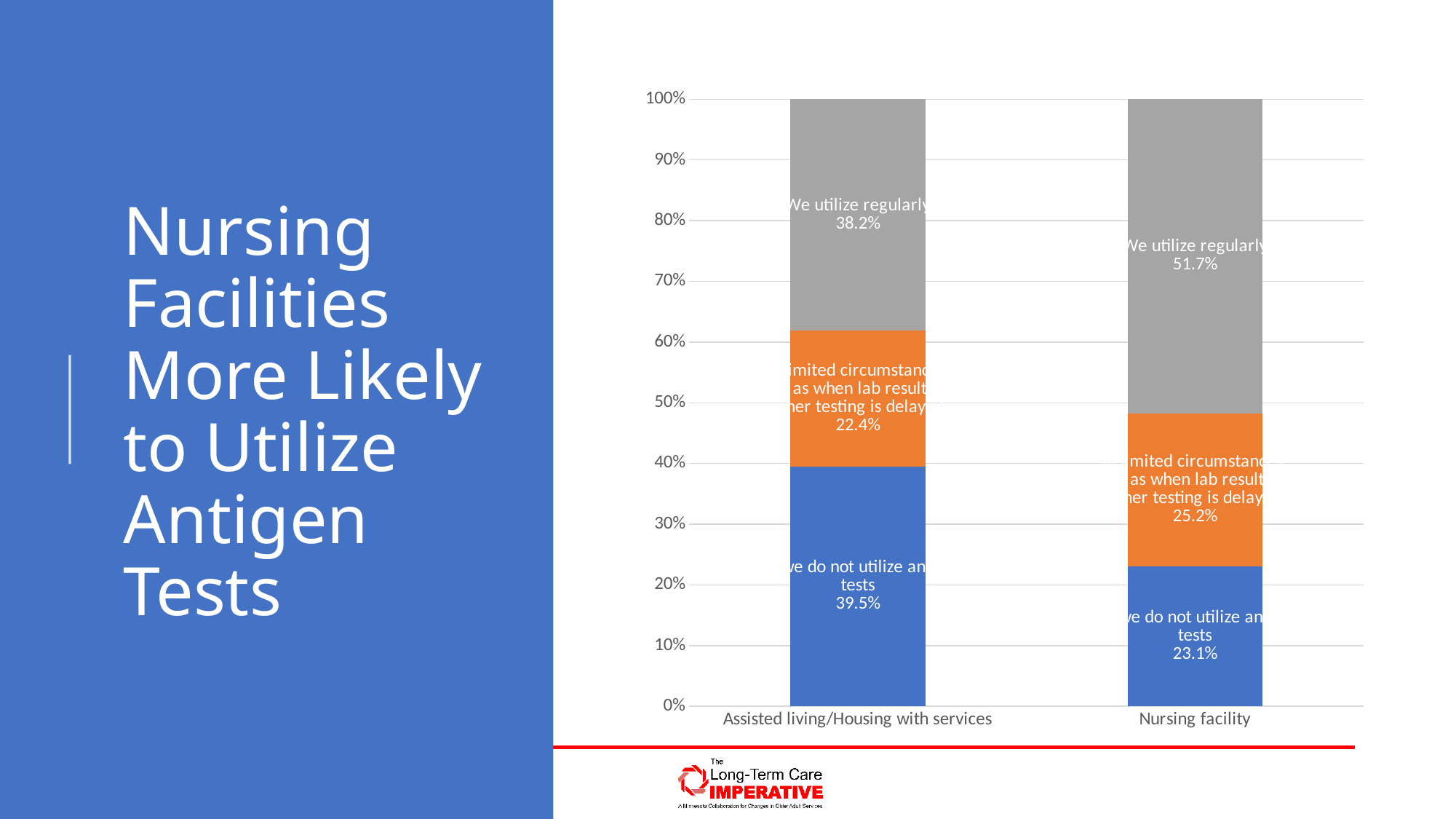
What percentage of nursing facilities responded "We utilize regularly"? 51.7% What is the difference between the "We do not utilize any tests" shares for Assisted living/Housing with services and Nursing facility? 16.4 percentage points What kind of chart is shown on the slide? Stacked bar chart What is the value of the "We do not utilize any tests" segment for Assisted living/Housing with services? 39.5% What percentage of nursing facilities use antigen tests only in limited circumstances? 25.2% What colour is the "We utilize regularly" segment in each bar? Gray What percentage of assisted living/housing with services respondents said "We utilize regularly"? 38.2% What percentage of assisted living/housing with services respondents use antigen tests only in limited circumstances? 22.4% How many percentage points higher is the "We utilize regularly" share for Nursing facility than for Assisted living/Housing with services? 13.5 percentage points Which facility type has the larger "We utilize regularly" share? Nursing facility What is the value of the "We do not utilize any tests" segment for Nursing facility? 23.1% How many facility types are shown on the x axis? 2